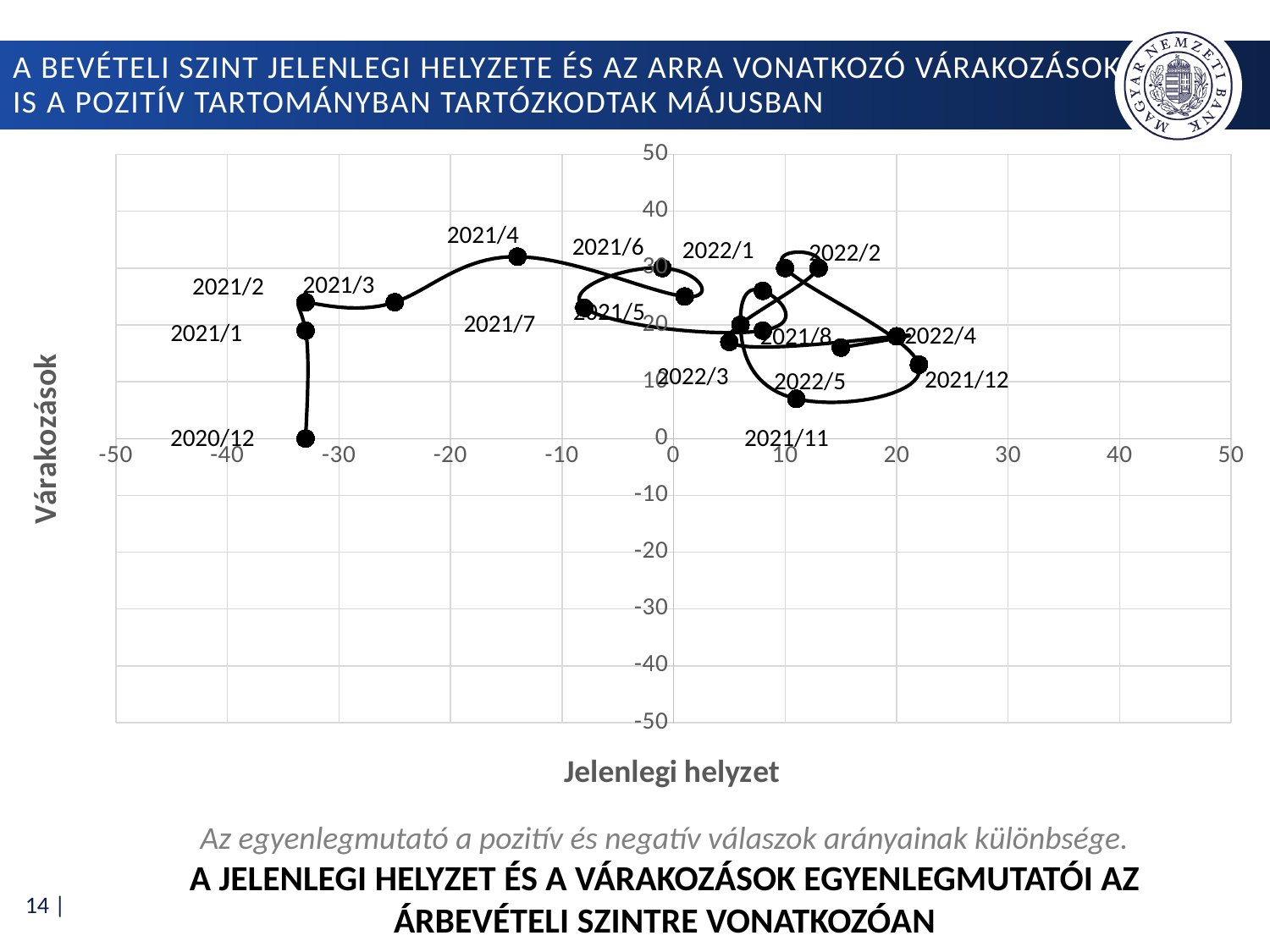
Is the horizontal-axis value (Jelenlegi helyzet) for 2021/1 greater or less than -20? less What kind of chart is shown on the slide? scatter chart Is the horizontal-axis value (Jelenlegi helyzet) for 2022/2 greater or less than 10? greater Is the vertical-axis value (Várakozások) for 2021/11 greater or less than 10? less How many labeled data points are shown on the chart? 16 What is the title of the vertical axis? Várakozások Which labeled point has the lowest vertical-axis value (Várakozások)? 2020/12 Which has the higher vertical-axis value (Várakozások): 2021/4 or 2020/12? 2021/4 What is the title of the horizontal axis? Jelenlegi helyzet